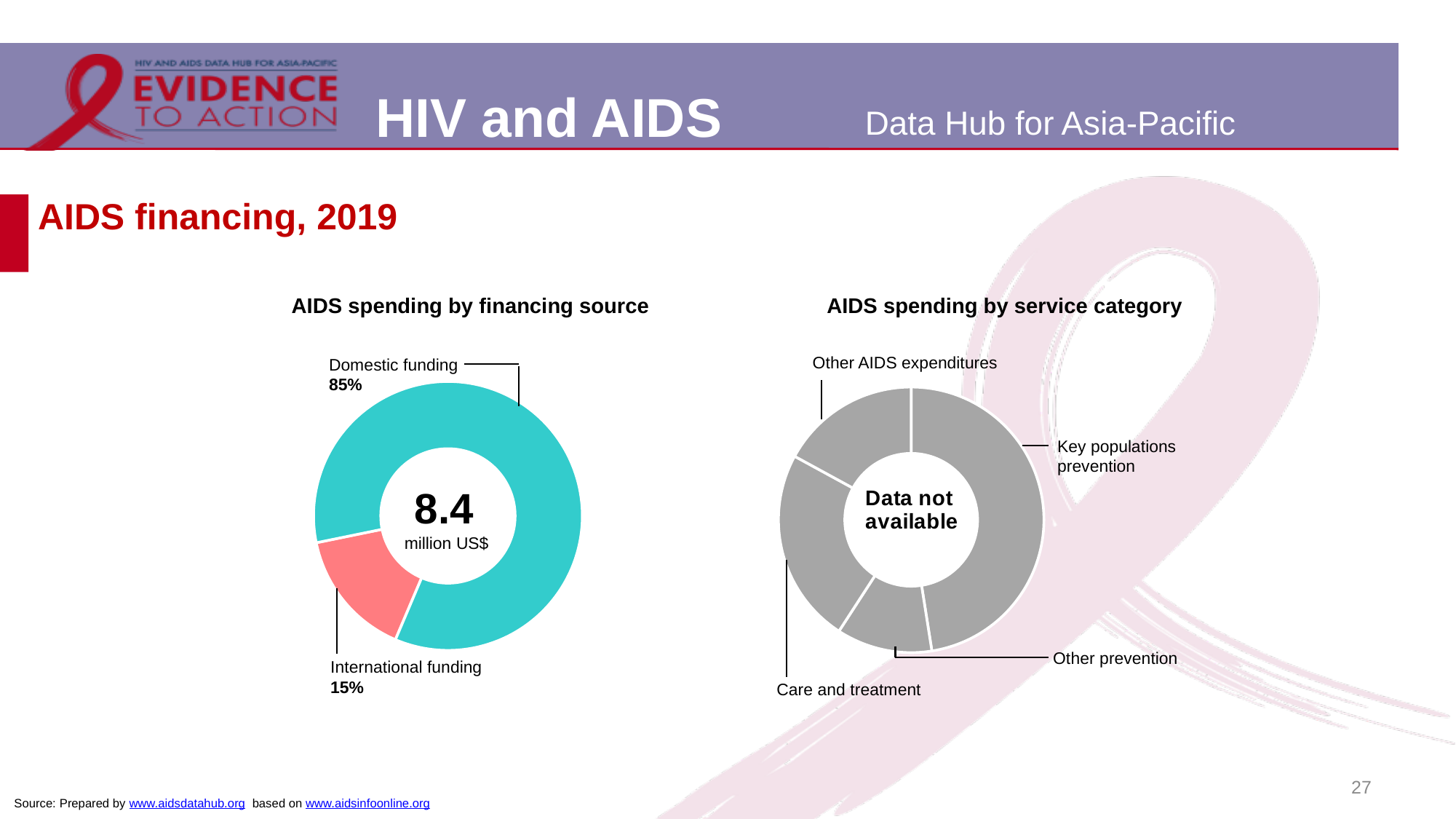
In the 'AIDS spending by financing source' chart, which is larger: domestic funding or international funding? Domestic funding In the 'AIDS spending by financing source' chart, what total value is shown in the centre of the donut? 8.4 million US$ In the 'AIDS spending by financing source' chart, what share of spending comes from international funding? 15% How many financing sources are shown in the 'AIDS spending by financing source' chart? 2 What type of chart is used for 'AIDS spending by financing source'? Donut (pie) chart What text appears in the centre of the 'AIDS spending by service category' chart? Data not available How many service categories are labelled in the 'AIDS spending by service category' chart? 4 In the 'AIDS spending by financing source' chart, what share of spending comes from domestic funding? 85% In the 'AIDS spending by financing source' chart, which financing source has the smallest share? International funding In the 'AIDS spending by financing source' chart, which financing source has the largest share? Domestic funding In the 'AIDS spending by financing source' chart, what is the difference in percentage points between domestic funding and international funding? 70 percentage points In the 'AIDS spending by financing source' chart, what colour is the international funding slice? Red (pink)